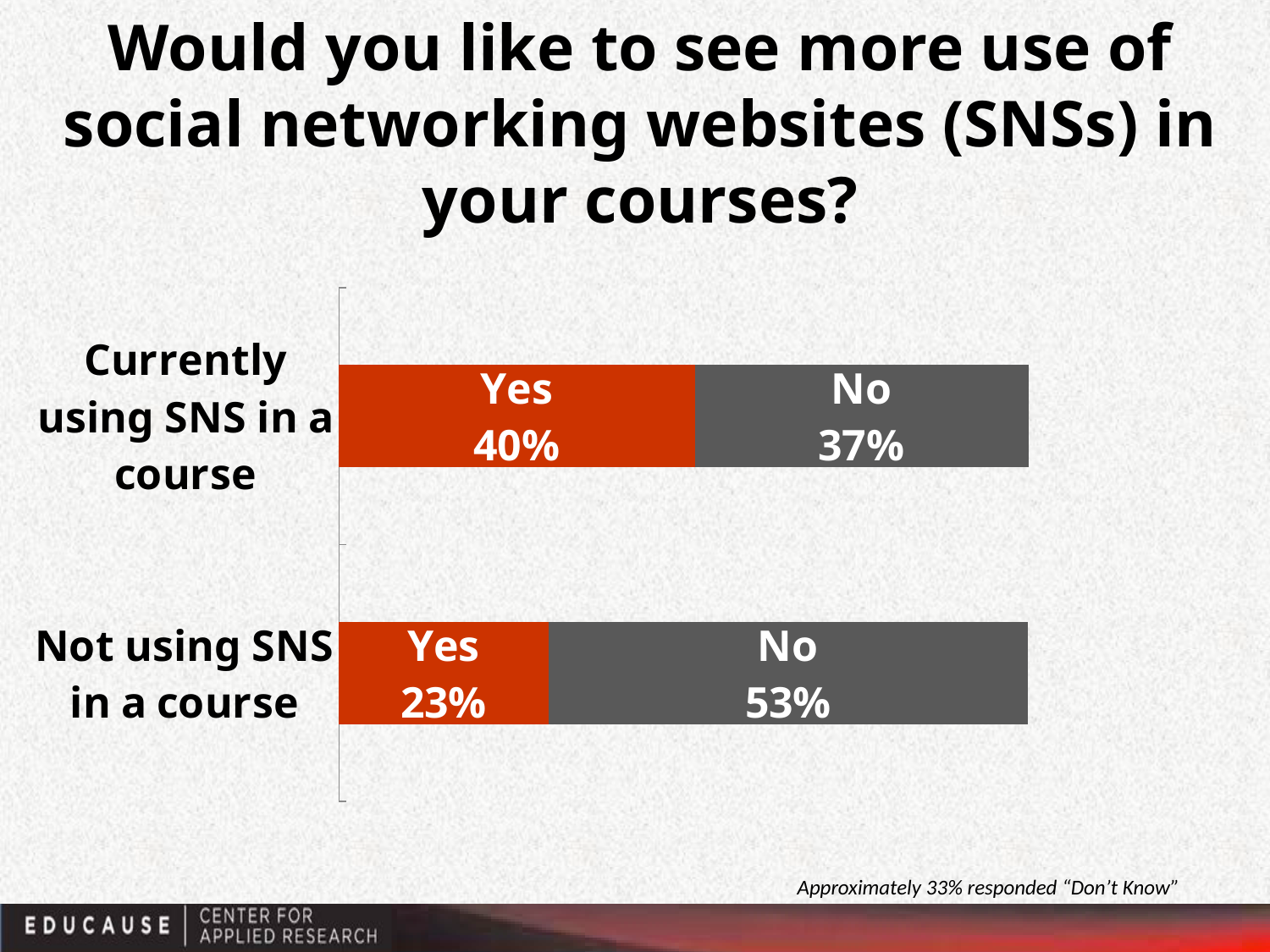
For respondents not using SNS in a course, which is larger, Yes or No? No What percentage of respondents currently using SNS in a course answered Yes? 40% What is the combined Yes and No percentage for respondents currently using SNS in a course? 77% What type of chart is shown on the slide? Stacked bar chart What percentage of respondents currently using SNS in a course answered No? 37% Which group has the lower No percentage? Currently using SNS in a course What is the difference between the No percentages of the two groups? 16% How many respondent groups are shown in the chart? 2 What is the difference between the Yes percentages of the two groups? 17% What percentage of respondents not using SNS in a course answered Yes? 23% What percentage of respondents not using SNS in a course answered No? 53% Which group has the higher Yes percentage? Currently using SNS in a course